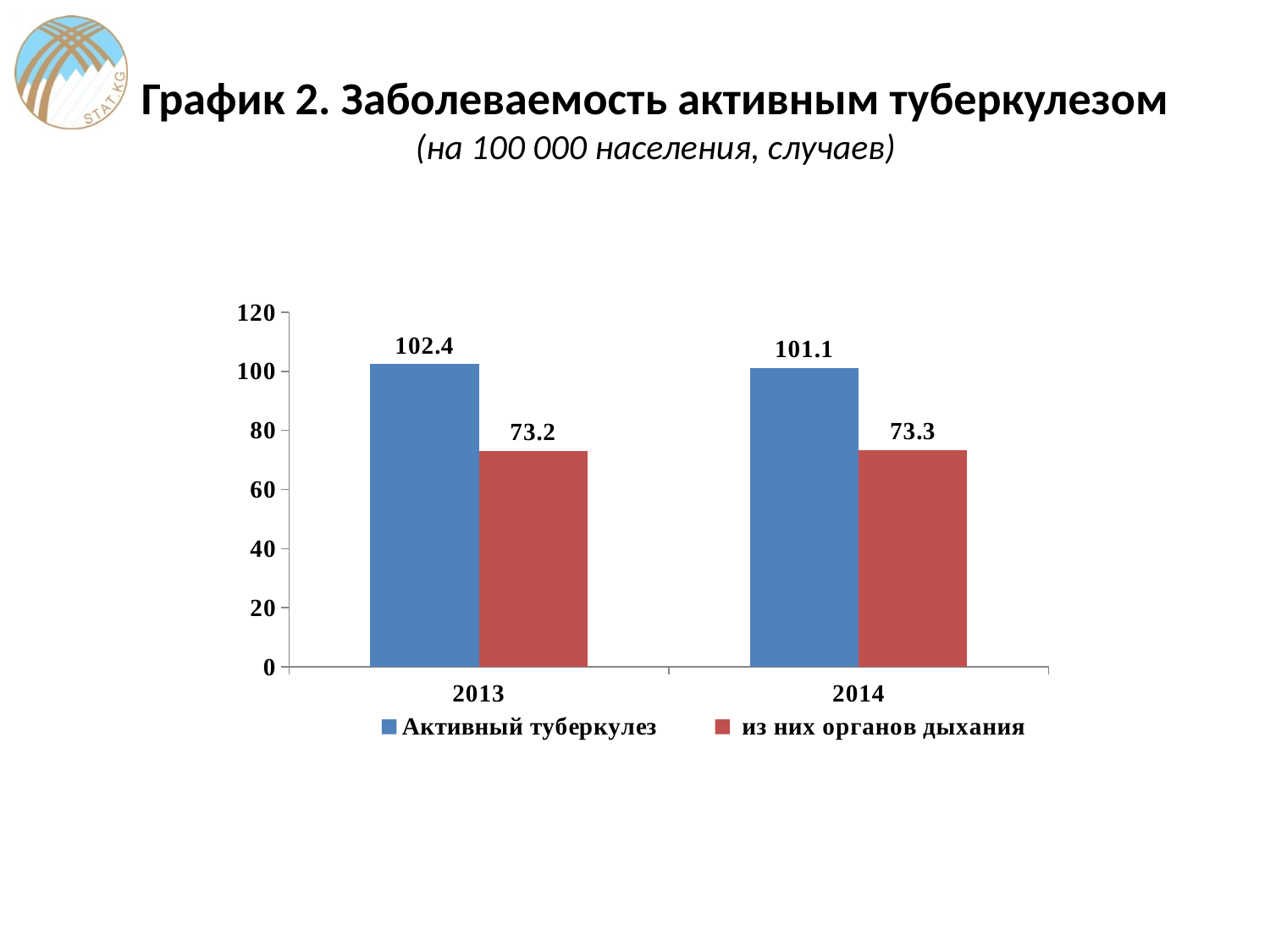
What kind of chart is shown on the slide? bar chart What is the value for Активный туберкулез in 2014? 101.1 What is the difference between Активный туберкулез and из них органов дыхания in 2013? 29.2 How many years are shown on the x axis? 2 Which is larger in 2014: Активный туберкулез or из них органов дыхания? Активный туберкулез How many series does the legend list? 2 What is the value for из них органов дыхания in 2013? 73.2 What is the value for из них органов дыхания in 2014? 73.3 What is the value for Активный туберкулез in 2013? 102.4 Is the value for Активный туберкулез in 2013 greater or less than 100? greater Which colour represents Активный туберкулез in the legend? blue What is the difference between Активный туберкулез in 2013 and in 2014? 1.3